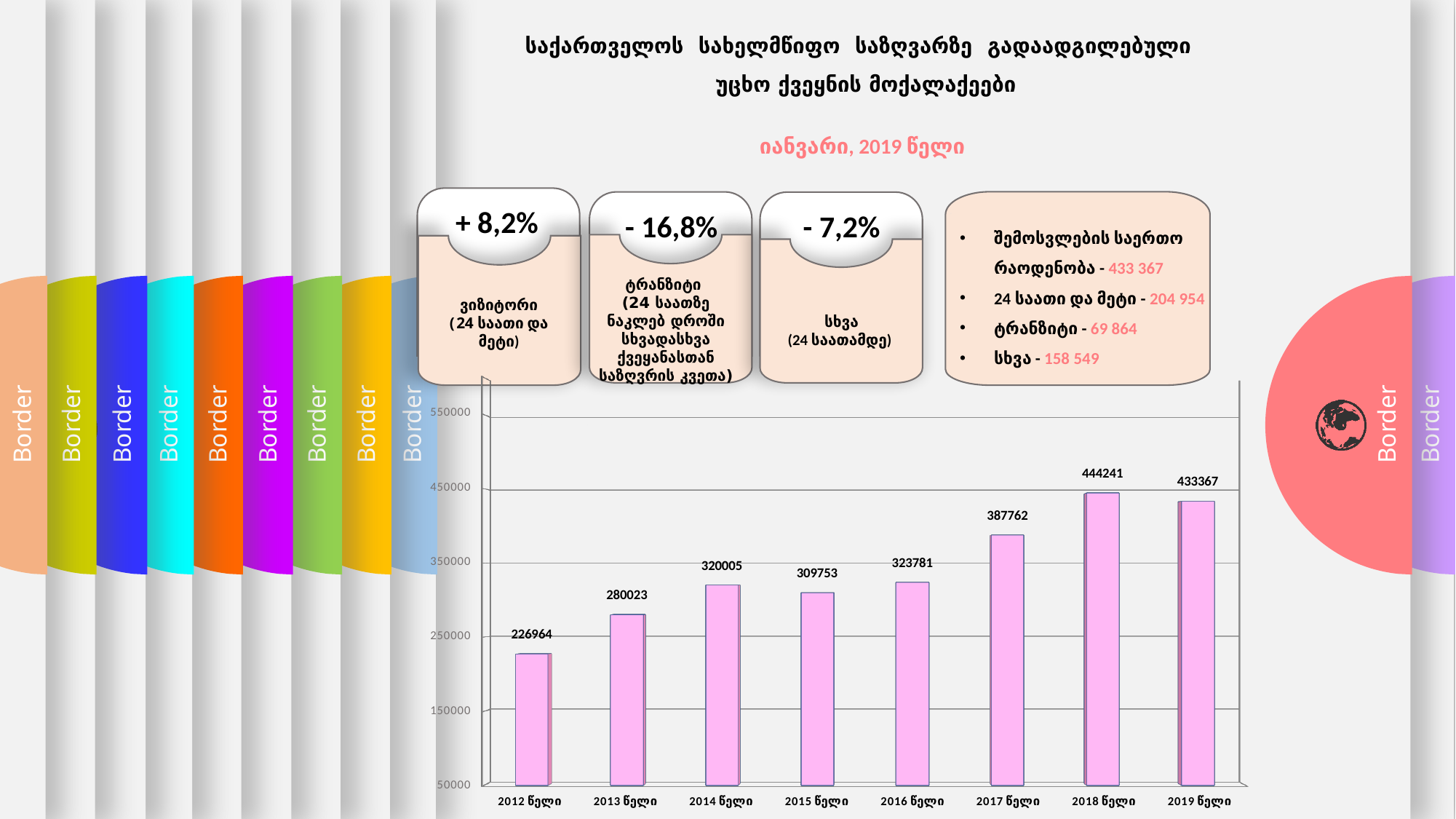
What is the value for 2019 in the bar chart? 433367 What is the difference between the values for 2018 and 2019? 10874 What is the value for 2012 in the bar chart? 226964 How many years are shown in the bar chart? 8 Which year has the highest value in the bar chart? 2018 Which is larger, the value for 2014 or the value for 2015? 2014 What is the difference between the values for 2013 and 2012? 53059 Do the values rise or fall from 2012 to 2014? rise Which year has the lowest value in the bar chart? 2012 What kind of chart is shown on the slide? bar chart Is the value for 2016 greater or less than 350000? less What is the value for 2017 in the bar chart? 387762